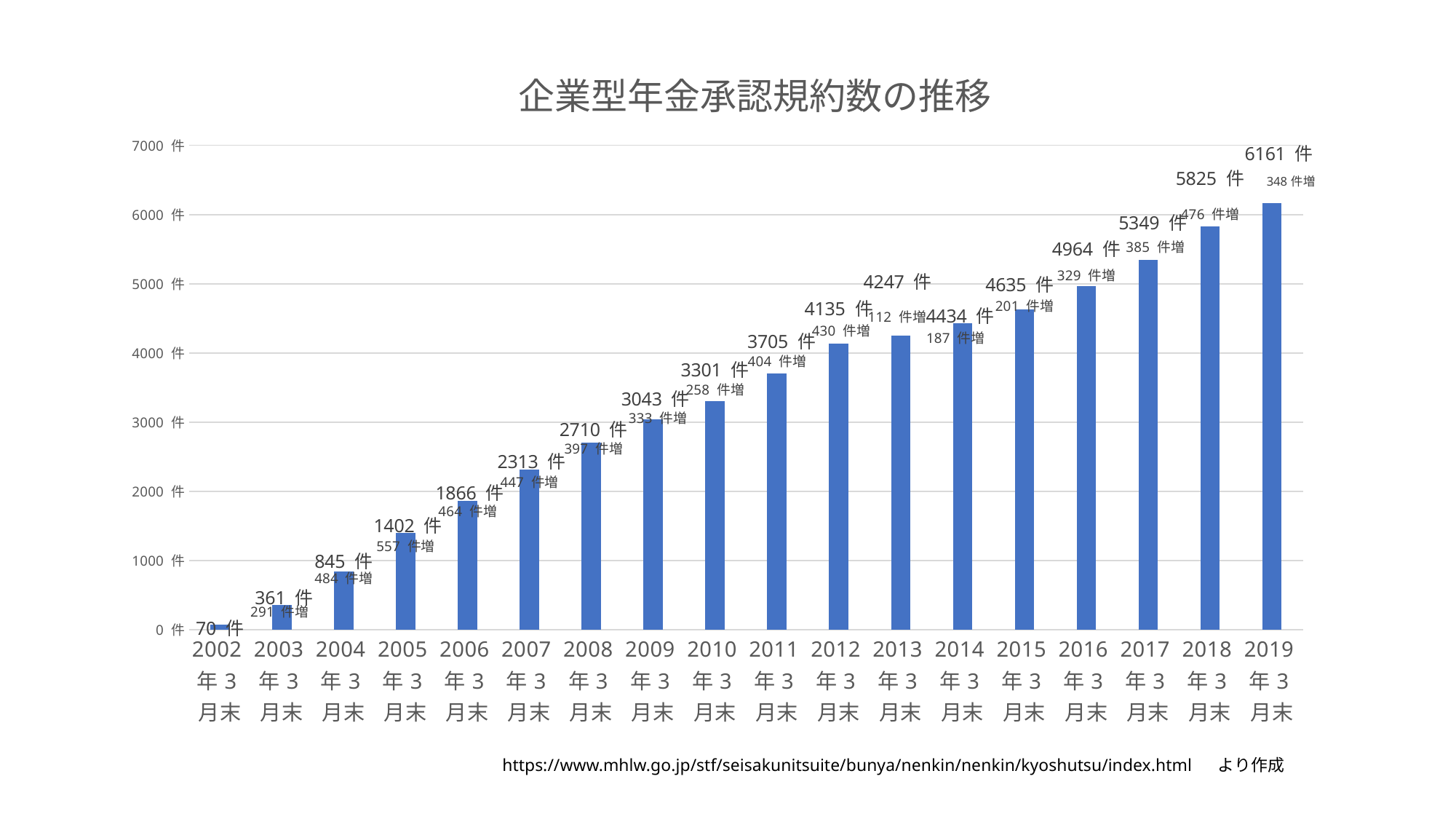
Which year has the highest value? 2019年3月末 What is the value for 2019年3月末? 6161 件 Which year has the lowest value? 2002年3月末 What is the difference between the values for 2019年3月末 and 2018年3月末? 336 件 How many years are shown on the x axis? 18 What is the difference between the values for 2008年3月末 and 2007年3月末? 397 件 Do the values rise or fall from 2002 to 2019? rise What is the value for 2010年3月末? 3301 件 What is the value for 2005年3月末? 1402 件 Which is larger, the value for 2012年3月末 or the value for 2013年3月末? 2013年3月末 Is the value for 2016年3月末 greater or less than 5000? less What kind of chart is this? bar chart